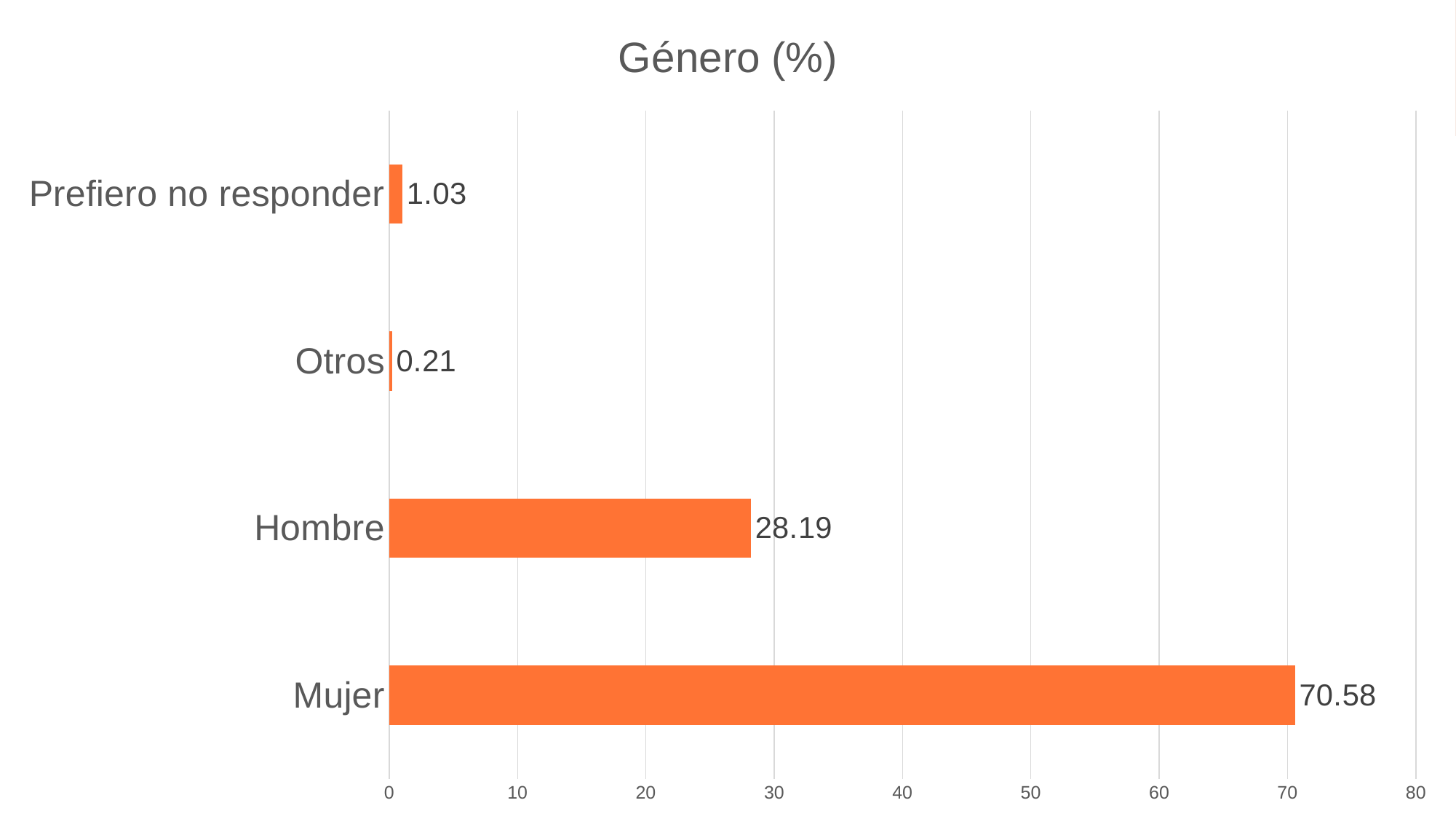
What is the value for Prefiero no responder? 1.03 What is the value for Hombre? 28.19 How many categories are shown in the chart? 4 What is the title of the chart? Género (%) What is the difference between the values for Mujer and Hombre? 42.39 What kind of chart is this? bar chart Is the value for Hombre greater or less than 30? less Which category has the highest value? Mujer What is the value for Mujer? 70.58 What is the value for Otros? 0.21 Which is larger, the value for Prefiero no responder or the value for Otros? Prefiero no responder Which category has the lowest value? Otros